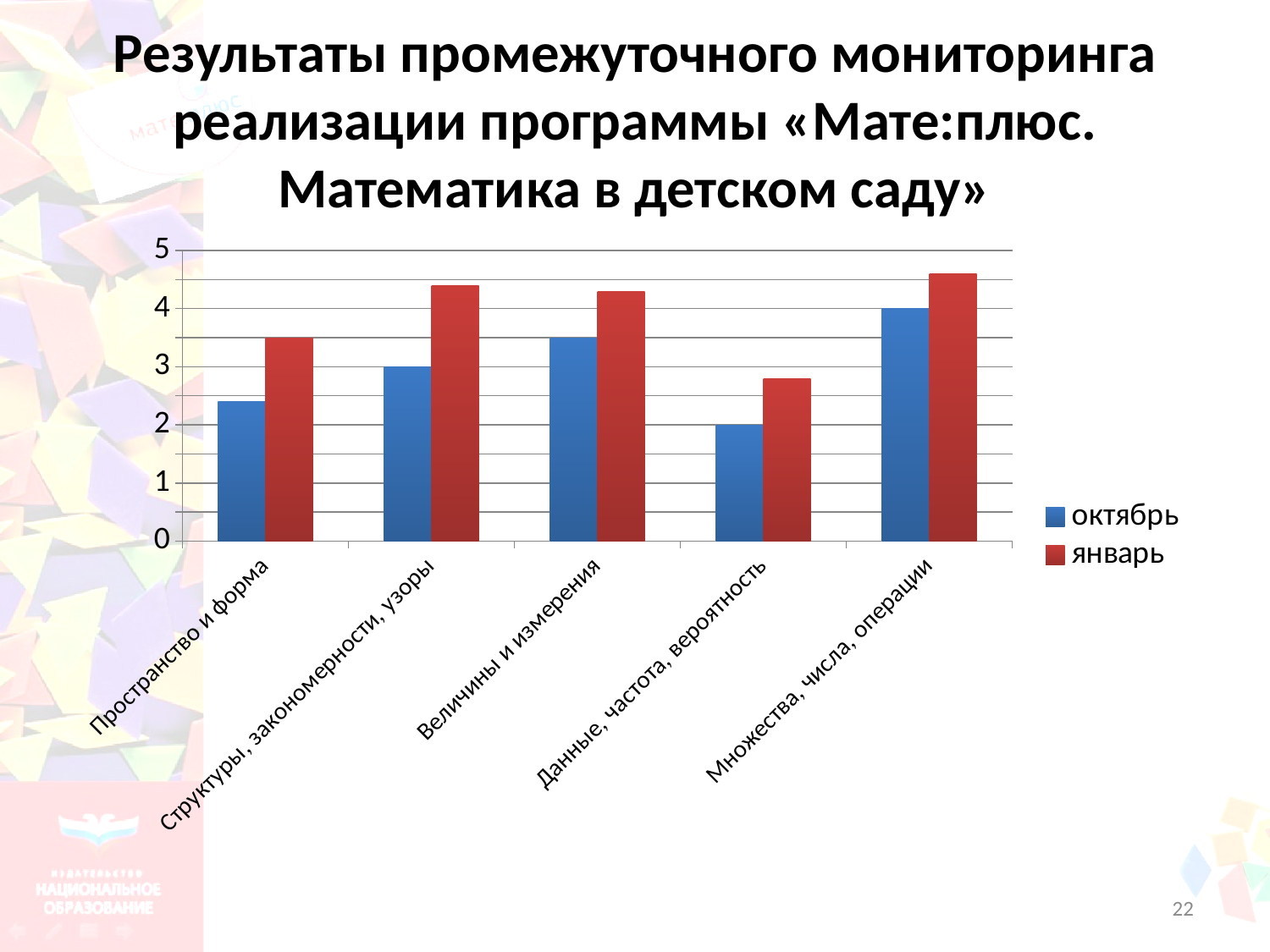
Which category has the lowest January (январь) value? Данные, частота, вероятность Is the January (январь) value for Данные, частота, вероятность greater or less than 3? less For Величины и измерения, which is larger: the October value or the January value? January (январь) What kind of chart is shown on the slide? bar chart How many categories are shown on the x axis? 5 What is the October (октябрь) value for Множества, числа, операции? 4 Which category has the highest October (октябрь) value? Множества, числа, операции Is the January (январь) value for Пространство и форма greater or less than 3? greater What is the October (октябрь) value for Структуры, закономерности, узоры? 3 Which series is shown in red? январь What is the October (октябрь) value for Данные, частота, вероятность? 2 How many series does the legend list? 2